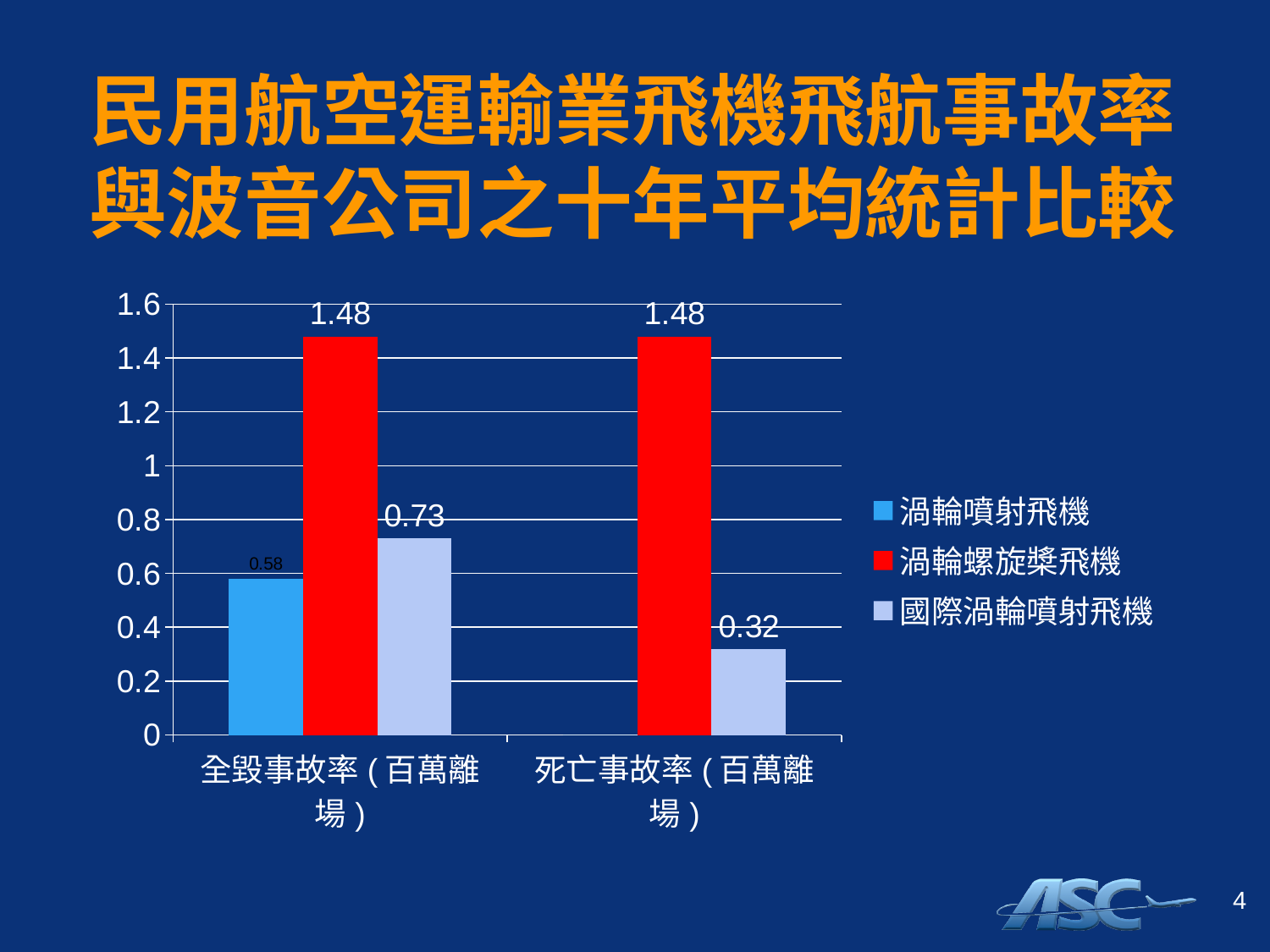
What is the value for 渦輪噴射飛機 in the 全毀事故率（百萬離場） category? 0.58 What is the value for 渦輪螺旋槳飛機 in the 全毀事故率（百萬離場） category? 1.48 Which colour represents 渦輪螺旋槳飛機 in the legend? red What is the difference between 渦輪螺旋槳飛機 and 國際渦輪噴射飛機 in the 全毀事故率（百萬離場） category? 0.75 How many series does the legend list? 3 Which series has the highest value in the 死亡事故率（百萬離場） category? 渦輪螺旋槳飛機 What is the value for 國際渦輪噴射飛機 in the 全毀事故率（百萬離場） category? 0.73 How many categories are shown on the x axis? 2 Which series has the lowest value in the 全毀事故率（百萬離場） category? 渦輪噴射飛機 What type of chart is shown on the slide? bar chart What is the value for 國際渦輪噴射飛機 in the 死亡事故率（百萬離場） category? 0.32 Which is larger in the 全毀事故率（百萬離場） category: 渦輪噴射飛機 or 國際渦輪噴射飛機? 國際渦輪噴射飛機